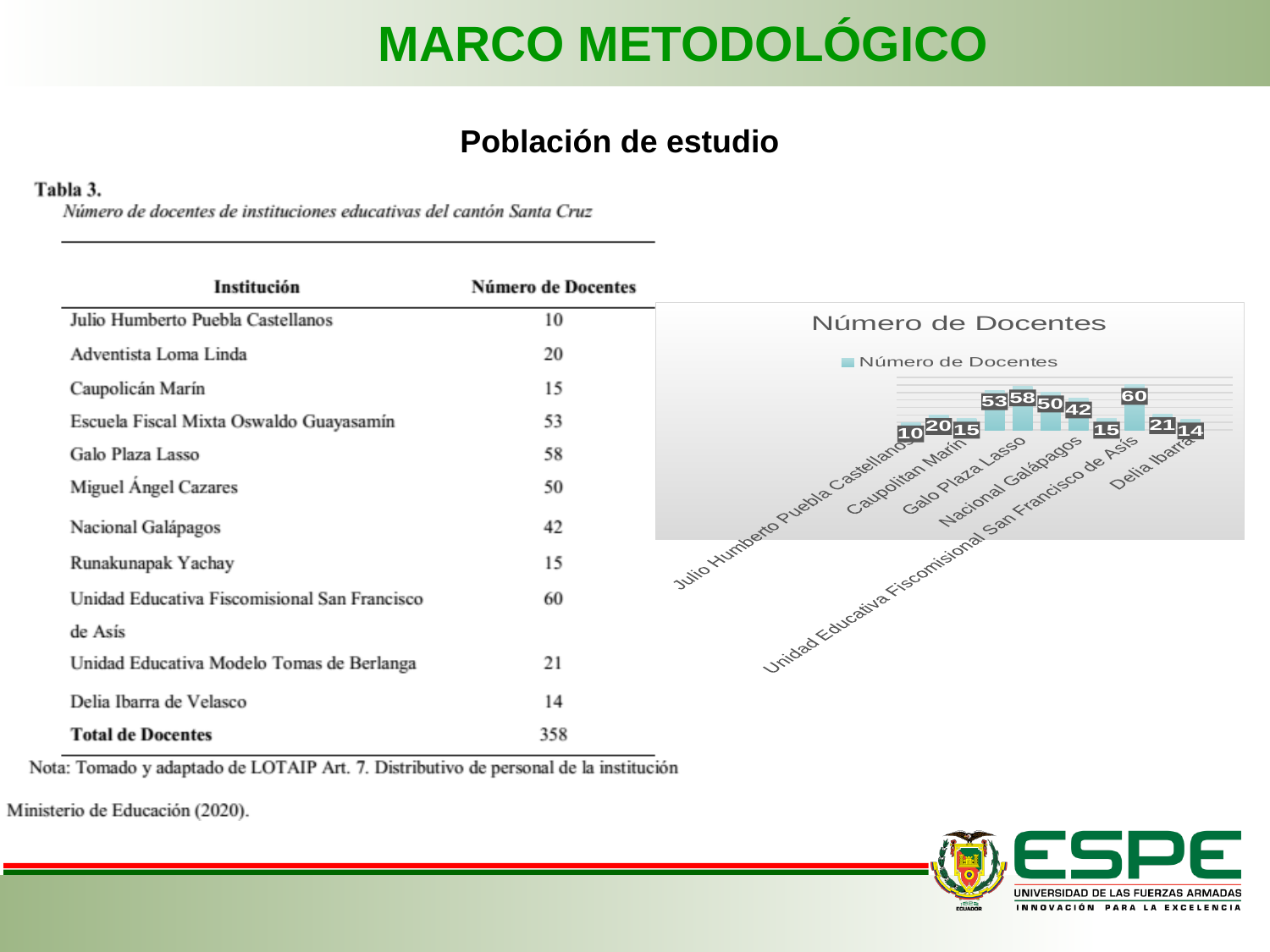
What is the value of the highest bar in the chart? 60 Which category has the highest value in the chart? Unidad Educativa Fiscomisional San Francisco de Asís Which category has the lowest value in the chart? Julio Humberto Puebla Castellanos How many series does the chart legend list? 1 Which is larger, the value for Galo Plaza Lasso or the value for Nacional Galápagos? Galo Plaza Lasso How many bars are plotted in the chart? 11 What kind of chart is shown on the slide? bar chart What is the value for Galo Plaza Lasso in the chart? 58 What is the value for Delia Ibarra in the chart? 14 What is the difference between the values for Galo Plaza Lasso and Caupolitan Marín? 43 What is the value for Nacional Galápagos in the chart? 42 What is the title of the chart? Número de Docentes